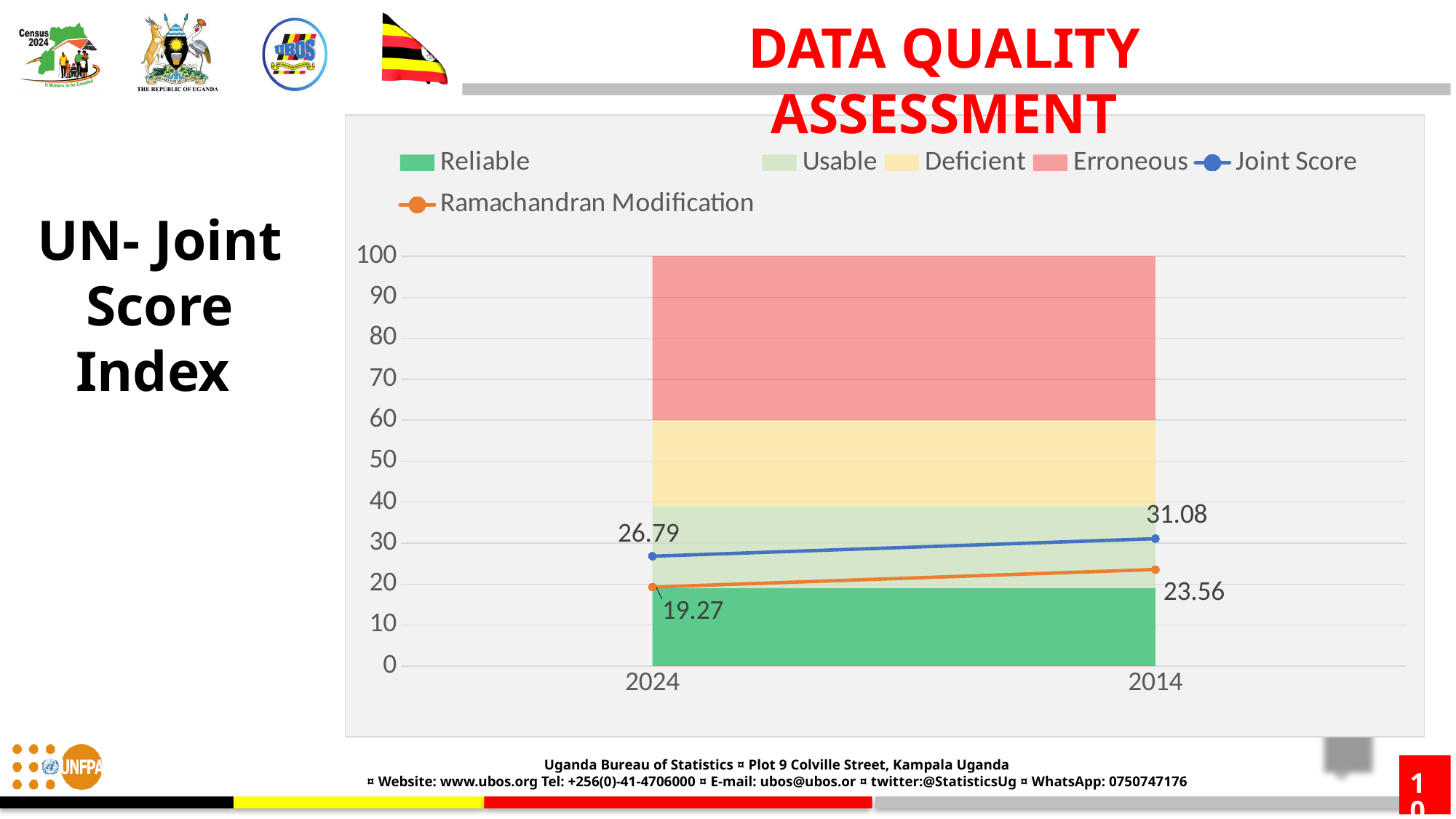
How many series does the legend list? 6 Is the Ramachandran Modification value for 2024 greater or less than 20? less What is the Ramachandran Modification value for 2014? 23.56 What is the Joint Score for 2024? 26.79 How many categories are shown on the x axis? 2 What is the difference between the Joint Score for 2014 and the Joint Score for 2024? 4.29 What is the Joint Score for 2014? 31.08 Which is larger, the Joint Score for 2024 or the Joint Score for 2014? 2014 What is the Ramachandran Modification value for 2024? 19.27 Which legend entry is shown in red? Erroneous What is the difference between the Joint Score and the Ramachandran Modification value for 2024? 7.52 Which series is drawn in orange? Ramachandran Modification